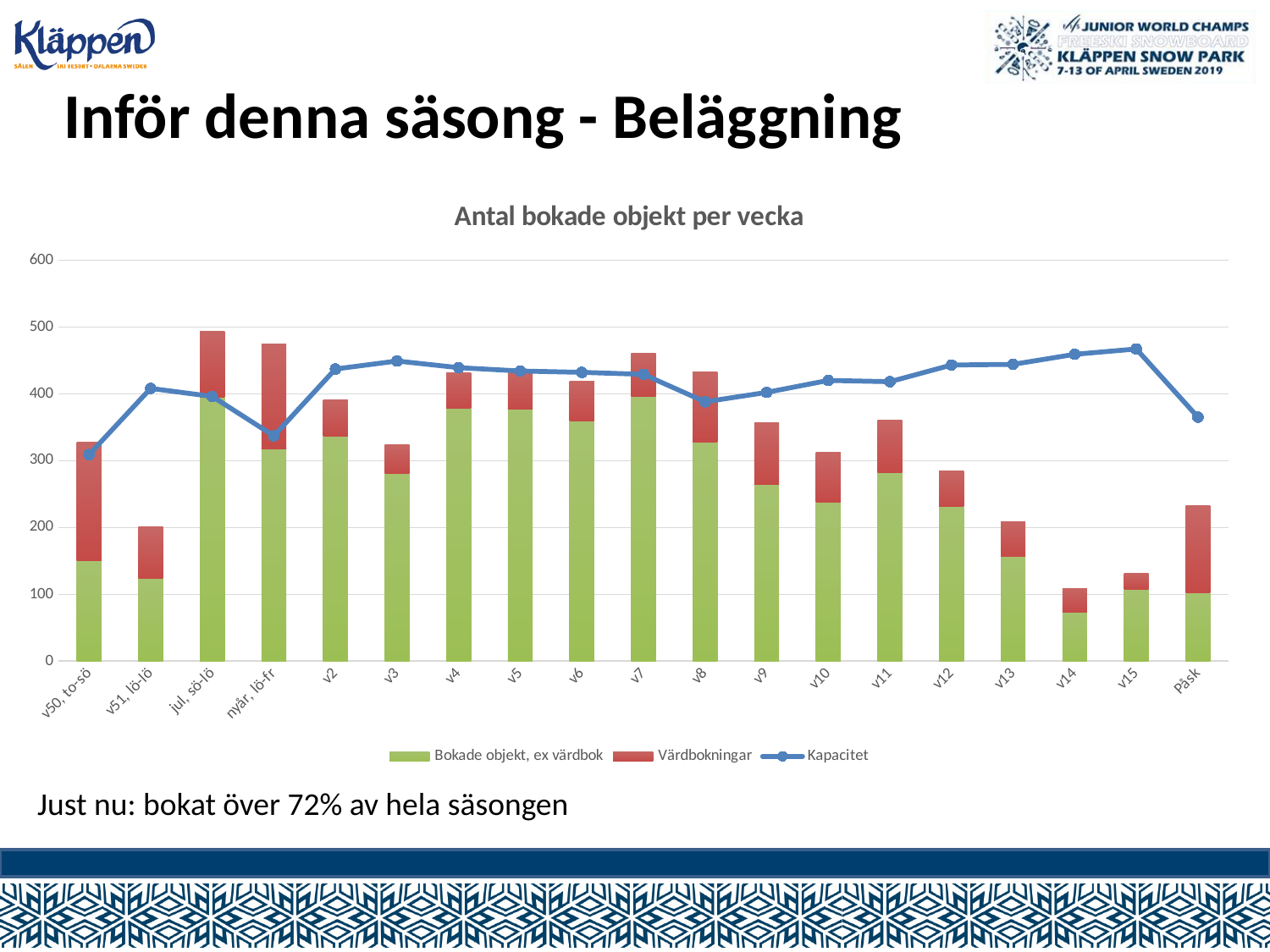
How many series does the chart's legend list? 3 Which has the taller stacked bar, v2 or v3? v2 Which category has the shortest stacked bar in the chart? v14 How many categories are shown along the x axis of the chart? 19 Which series is drawn as a line in the chart? Kapacitet What is the title of the chart? Antal bokade objekt per vecka Is the total stacked bar for v14 greater or less than 200? less Which category has the tallest stacked bar in the chart? jul, sö-lö What kind of chart is shown on the slide? Bar chart with a line Which category has the lowest Kapacitet value in the chart? v50, to-sö Is the Kapacitet value for Påsk greater or less than 400? less Do the stacked bar totals rise or fall from v9 to v14? fall